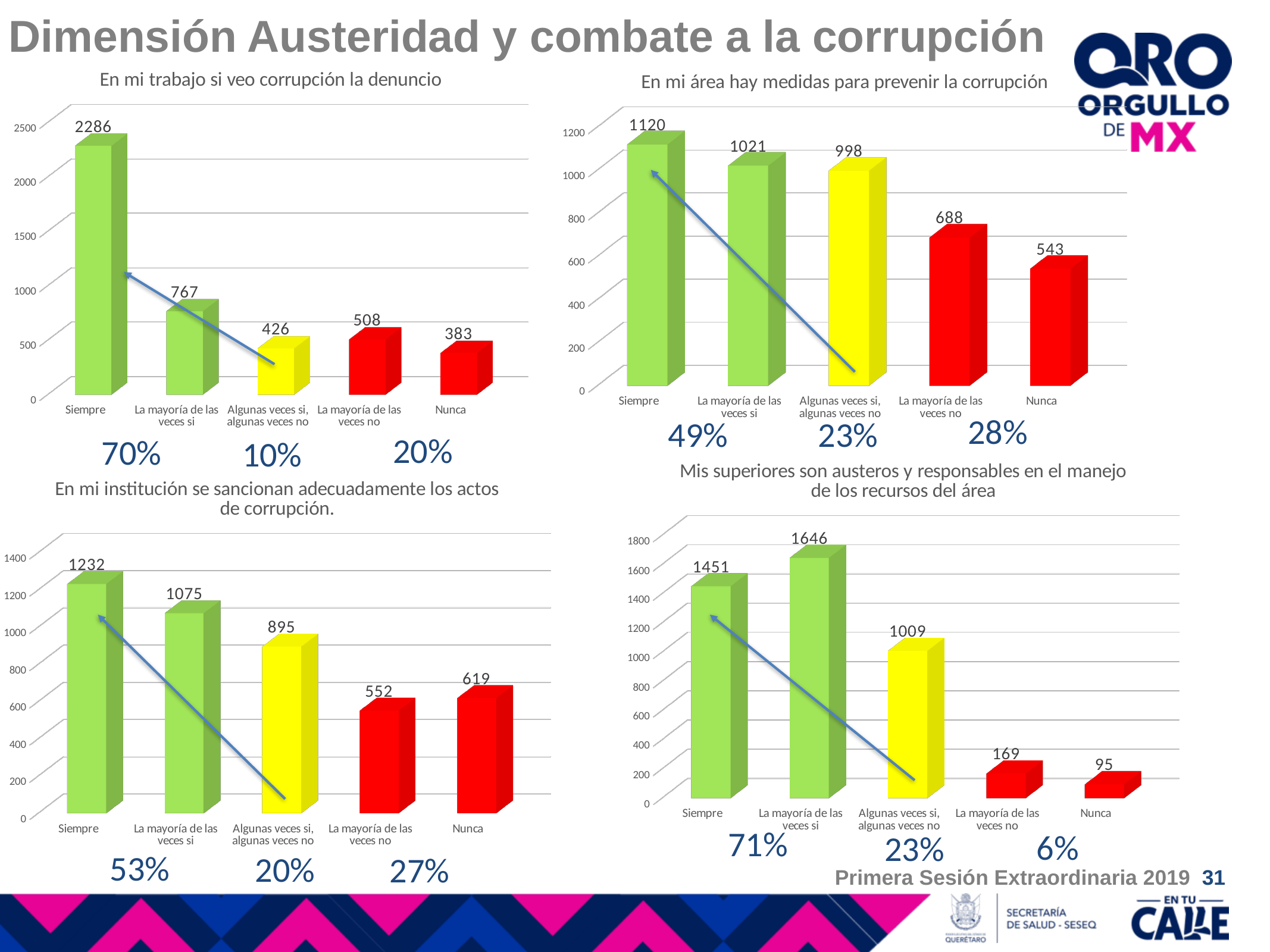
In the chart 'Mis superiores son austeros y responsables en el manejo de los recursos del área', what is the value for La mayoría de las veces si? 1646 In the chart 'En mi institución se sancionan adecuadamente los actos de corrupción.', what is the value for Algunas veces si, algunas veces no? 895 What kind of chart is 'En mi área hay medidas para prevenir la corrupción'? Bar chart In the chart 'En mi área hay medidas para prevenir la corrupción', what is the difference between Siempre and La mayoría de las veces si? 99 In the chart 'En mi trabajo si veo corrupción la denuncio', what is the value for Siempre? 2286 In the chart 'Mis superiores son austeros y responsables en el manejo de los recursos del área', what is the difference between Siempre and Nunca? 1356 How many categories are shown in the chart 'En mi trabajo si veo corrupción la denuncio'? 5 In the chart 'En mi institución se sancionan adecuadamente los actos de corrupción.', which is larger: La mayoría de las veces no or Nunca? Nunca In the chart 'Mis superiores son austeros y responsables en el manejo de los recursos del área', which category has the lowest value? Nunca In the chart 'En mi área hay medidas para prevenir la corrupción', what is the value for Nunca? 543 In the chart 'En mi institución se sancionan adecuadamente los actos de corrupción.', which category has the highest value? Siempre In the chart 'En mi trabajo si veo corrupción la denuncio', which category has the lowest value? Nunca